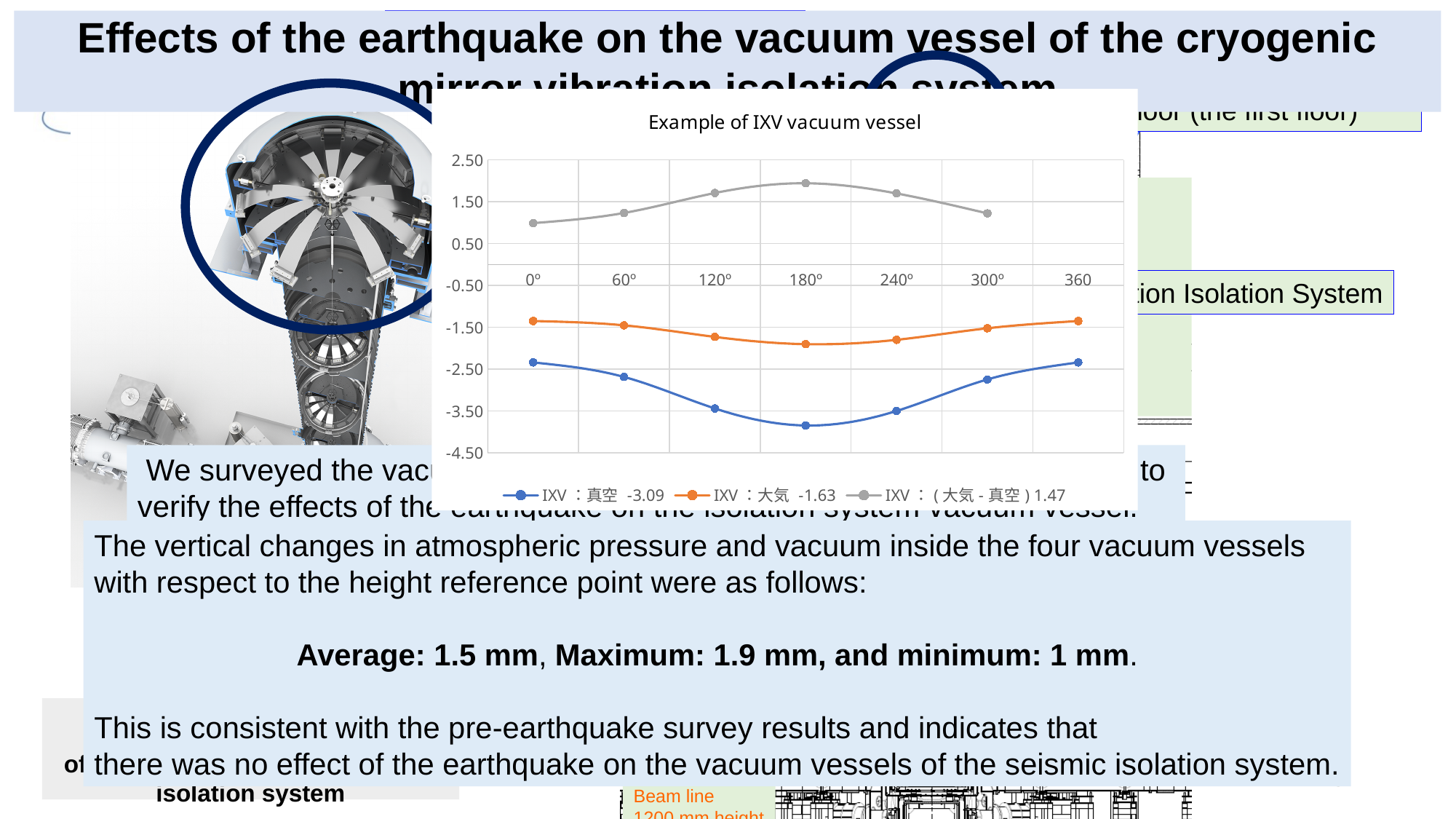
Is the value of the blue series (IXV：真空 -3.09) at 180° greater or less than -3.50? less What kind of chart is shown on the slide? line chart What is the title of the chart? Example of IXV vacuum vessel At 120°, which series has the larger value: the gray series or the blue series? the gray series At which angle does the blue series (IXV：真空 -3.09) reach its lowest value? 180° Is the value of the gray series (IXV：(大気 - 真空) 1.47) at 180° greater or less than 1.50? greater Does the blue series (IXV：真空 -3.09) rise or fall from 0° to 180°? fall At which angle does the orange series (IXV：大気 -1.63) reach its lowest value? 180° How many angle positions are labelled along the x axis of the chart? 7 Is the value of the gray series (IXV：(大気 - 真空) 1.47) at 0° greater or less than 0.50? greater How many series does the chart legend list? 3 At which angle does the gray series (IXV：(大気 - 真空) 1.47) reach its highest value? 180°